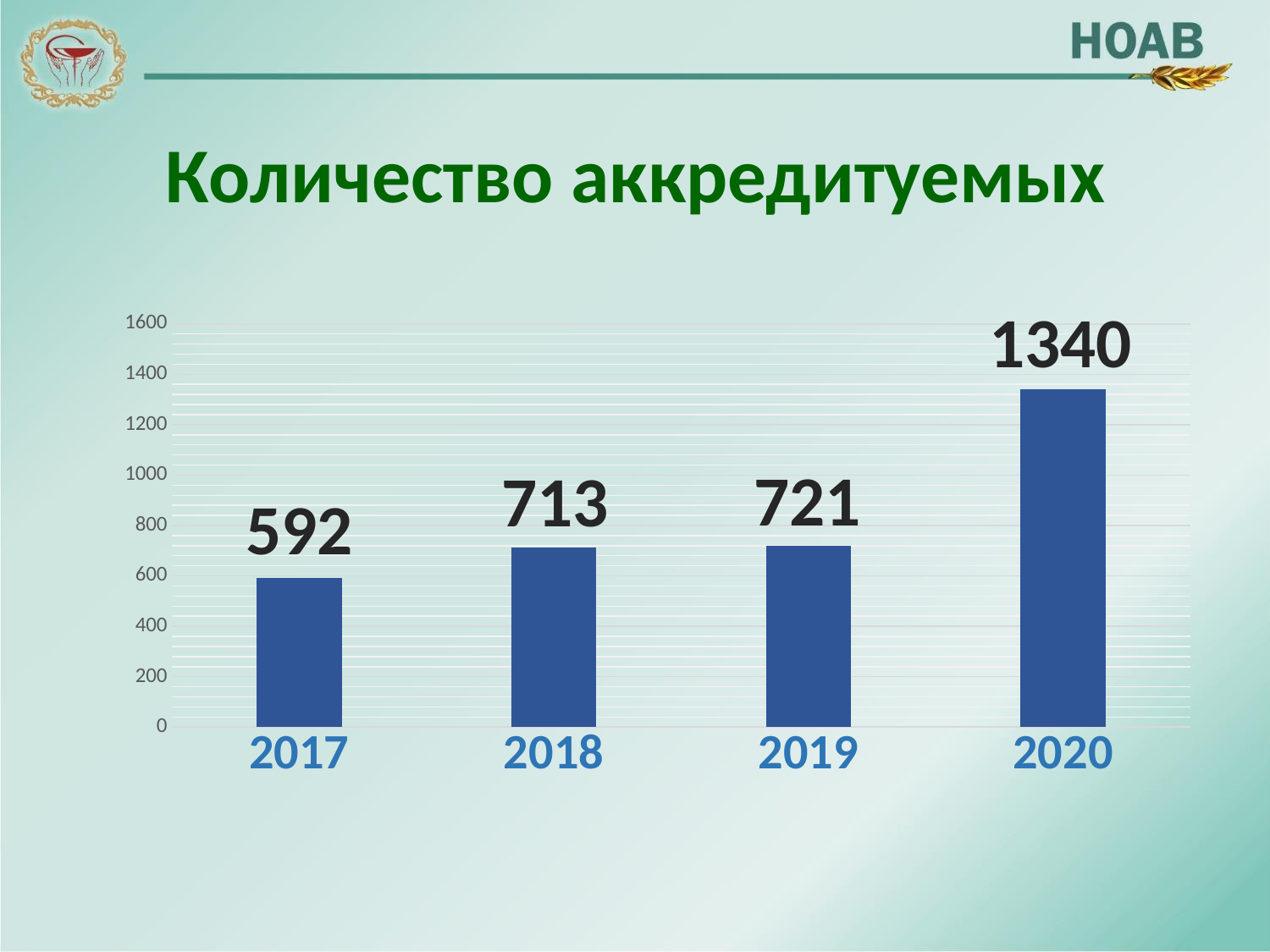
What is the value for 2020? 1340 What kind of chart is shown on the slide? bar chart What is the difference between the values for 2020 and 2019? 619 Which year has the highest value? 2020 Do the values rise or fall from 2017 to 2020? rise Is the value for 2020 greater or less than 1200? greater Which is larger, the value for 2017 or the value for 2018? 2018 Which year has the lowest value? 2017 What is the difference between the values for 2018 and 2017? 121 What is the value for 2017? 592 How many years are shown on the x axis? 4 What is the value for 2018? 713